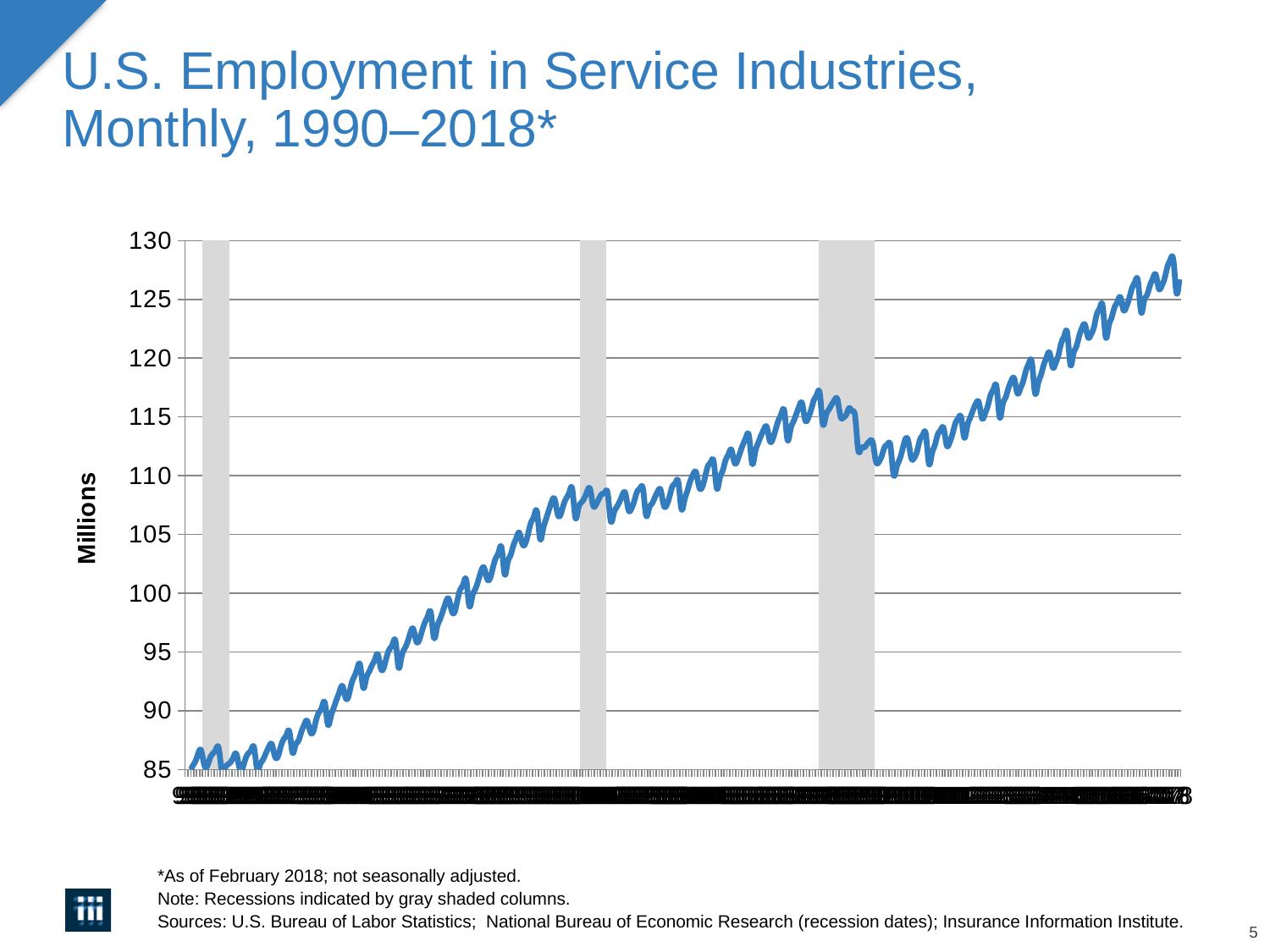
Is the value at the end of the series greater or less than the value at the start of the series? greater Is the lowest point of the line greater or less than 90? less What kind of chart is shown on the slide? line chart What is the label on the y axis? Millions Overall, do the values rise or fall from the left of the x axis to the right? rise How many gray shaded recession columns are shown on the chart? 3 Is the value at the start of the series (left end of the line) greater or less than 90? less Is the value at the end of the series (right end of the line) greater or less than 120? greater